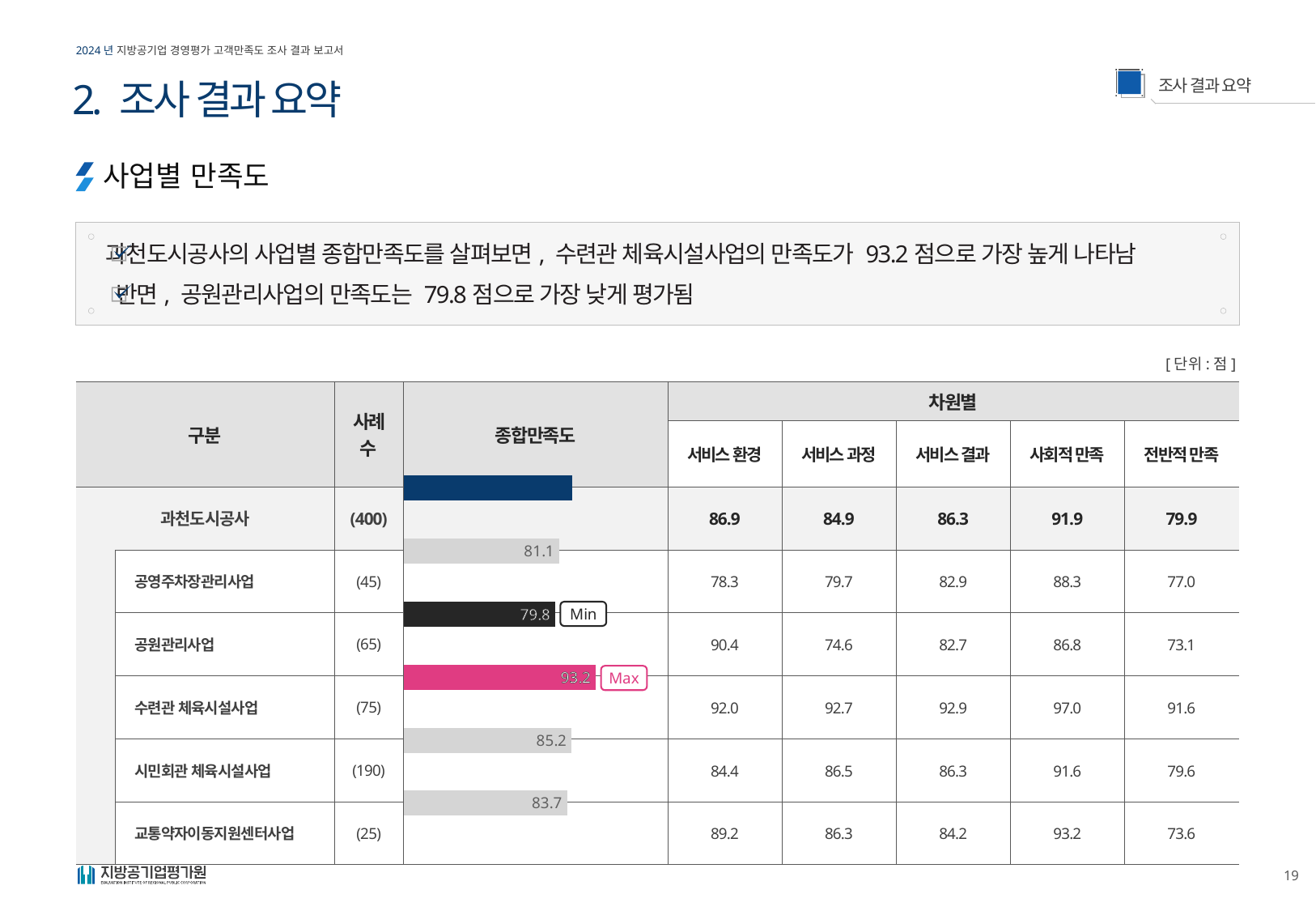
In the 종합만족도 bar chart, what is the value for 시민회관 체육시설사업? 85.2 In the 종합만족도 bar chart, which business has the highest value (marked Max)? 수련관 체육시설사업 In the 종합만족도 bar chart, what colour is the bar labelled Max? pink How many bars are shown in the 종합만족도 bar chart? 6 In the 종합만족도 bar chart, which is larger: the value for 시민회관 체육시설사업 or for 교통약자이동지원센터사업? 시민회관 체육시설사업 In the 종합만족도 bar chart, what is the value for 교통약자이동지원센터사업? 83.7 In the 종합만족도 bar chart, what is the value for 공영주차장관리사업? 81.1 In the 종합만족도 bar chart, what is the value for 수련관 체육시설사업? 93.2 In the 종합만족도 bar chart, what is the value for 공원관리사업? 79.8 In the 종합만족도 bar chart, which business has the lowest value (marked Min)? 공원관리사업 In the 종합만족도 bar chart, what is the difference between the Max value (93.2) and the Min value (79.8)? 13.4 What kind of chart is embedded in the 종합만족도 column of the table? bar chart